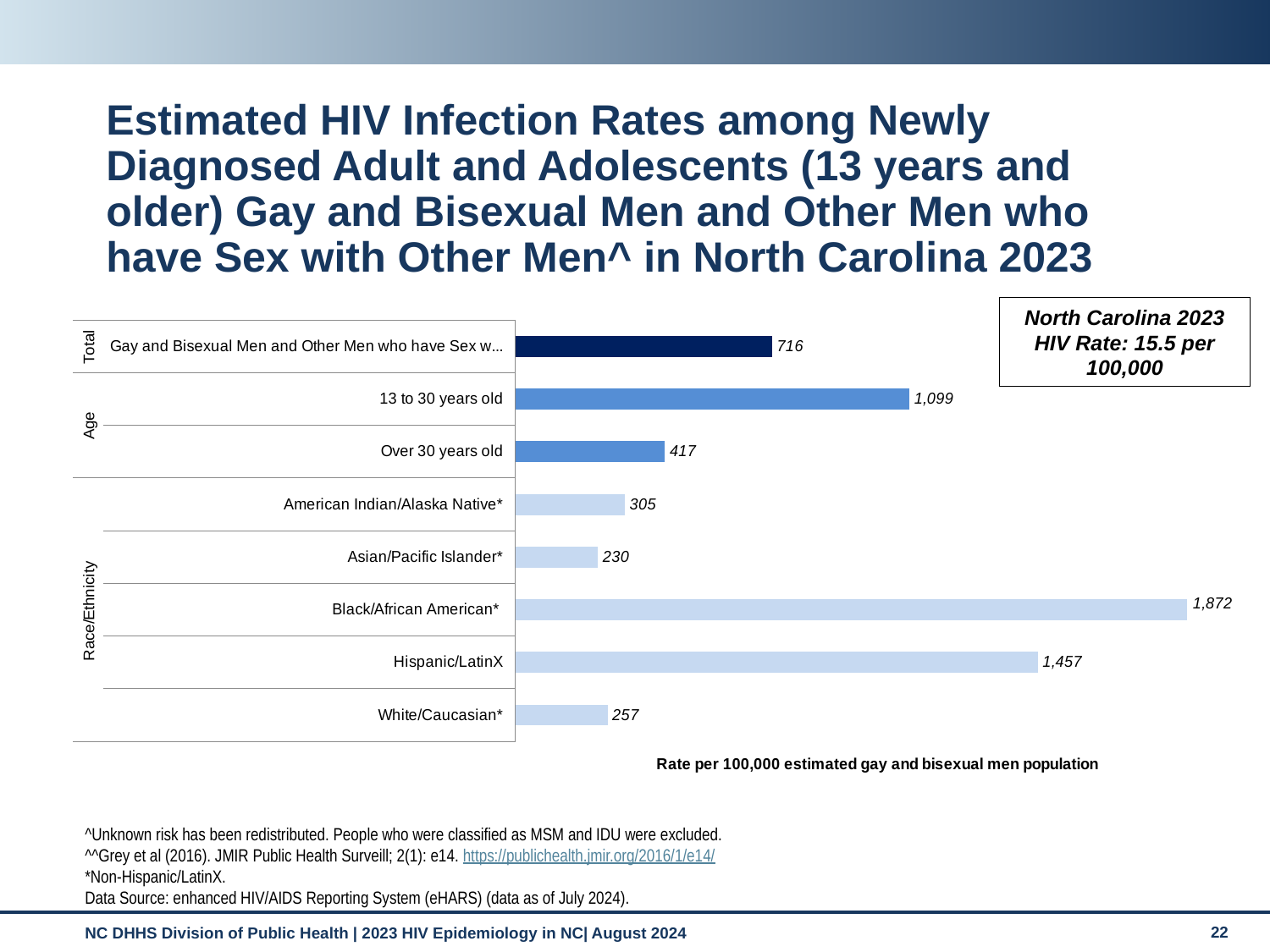
What kind of chart is shown on the slide? Bar chart What is the total estimated HIV infection rate for gay and bisexual men and other men who have sex with men? 716 What is the difference between the rates for 13 to 30 years old and Over 30 years old? 682 What is the difference between the rates for Black/African American* and Hispanic/LatinX? 415 What is the estimated HIV infection rate for the 13 to 30 years old group? 1,099 Which has a higher estimated HIV infection rate, American Indian/Alaska Native* or White/Caucasian*? American Indian/Alaska Native* What is the North Carolina 2023 HIV rate shown in the box on the slide? 15.5 per 100,000 What is the estimated HIV infection rate for Black/African American* gay and bisexual men? 1,872 How many bars are plotted on the chart? 8 What is the estimated HIV infection rate for Hispanic/LatinX gay and bisexual men? 1,457 Which category on the chart has the lowest estimated HIV infection rate? Asian/Pacific Islander* Which race/ethnicity category has the highest estimated HIV infection rate? Black/African American*